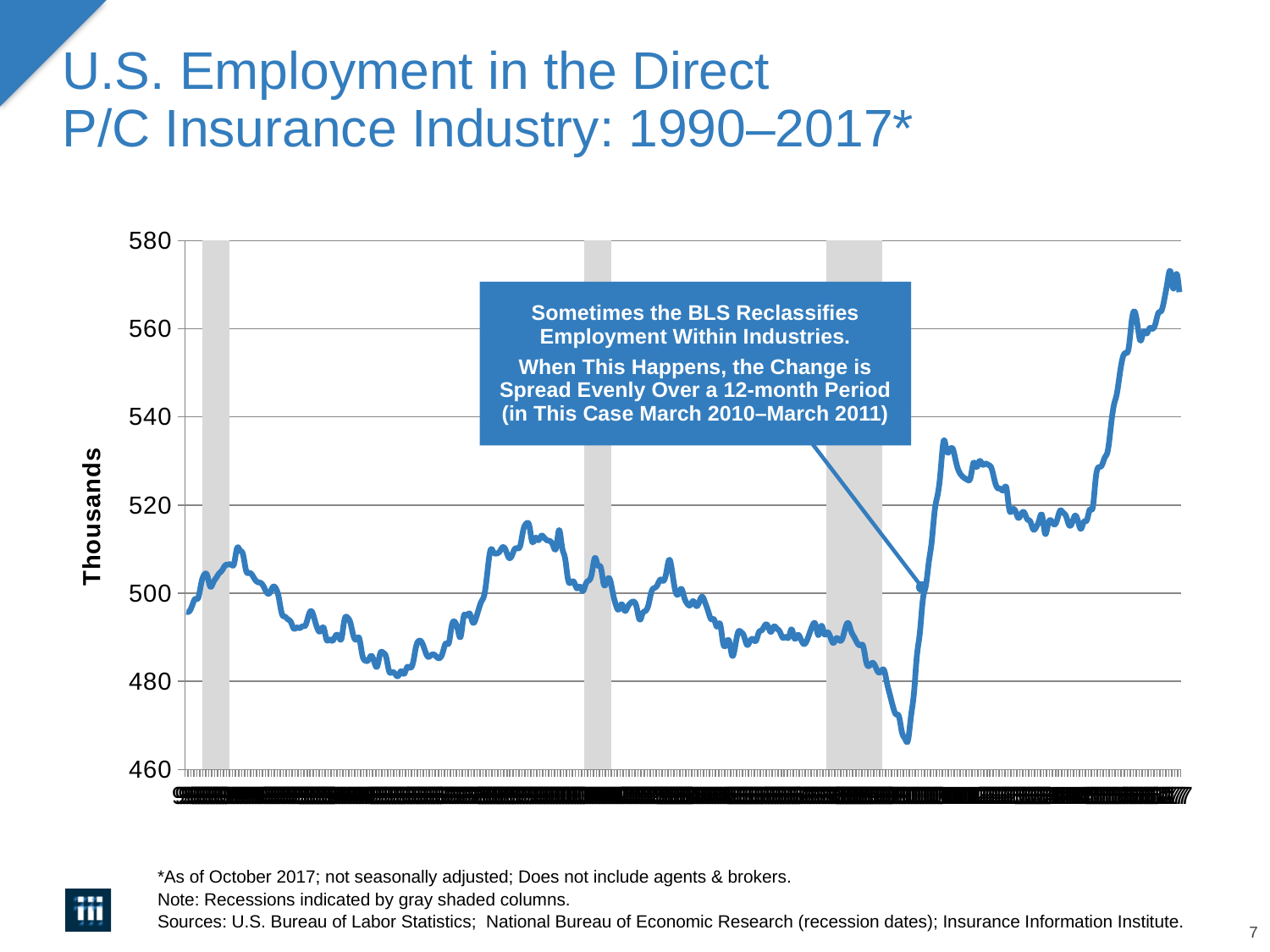
Is the value at the start of the line (left end) greater or less than 500? less Is the lowest point of the employment line greater or less than 480? less Is the highest point of the employment line greater or less than 560? greater What kind of chart is shown on the slide? line chart What is the highest value shown on the vertical axis? 580 How many gray shaded recession columns appear on the chart? 3 Comparing the start of the line to the end of the line, does employment rise or fall overall? rise Which is larger: the value at the right end of the line or the value at the left end of the line? the right end What is the lowest value shown on the vertical axis? 460 What is the label on the vertical axis of the chart? Thousands